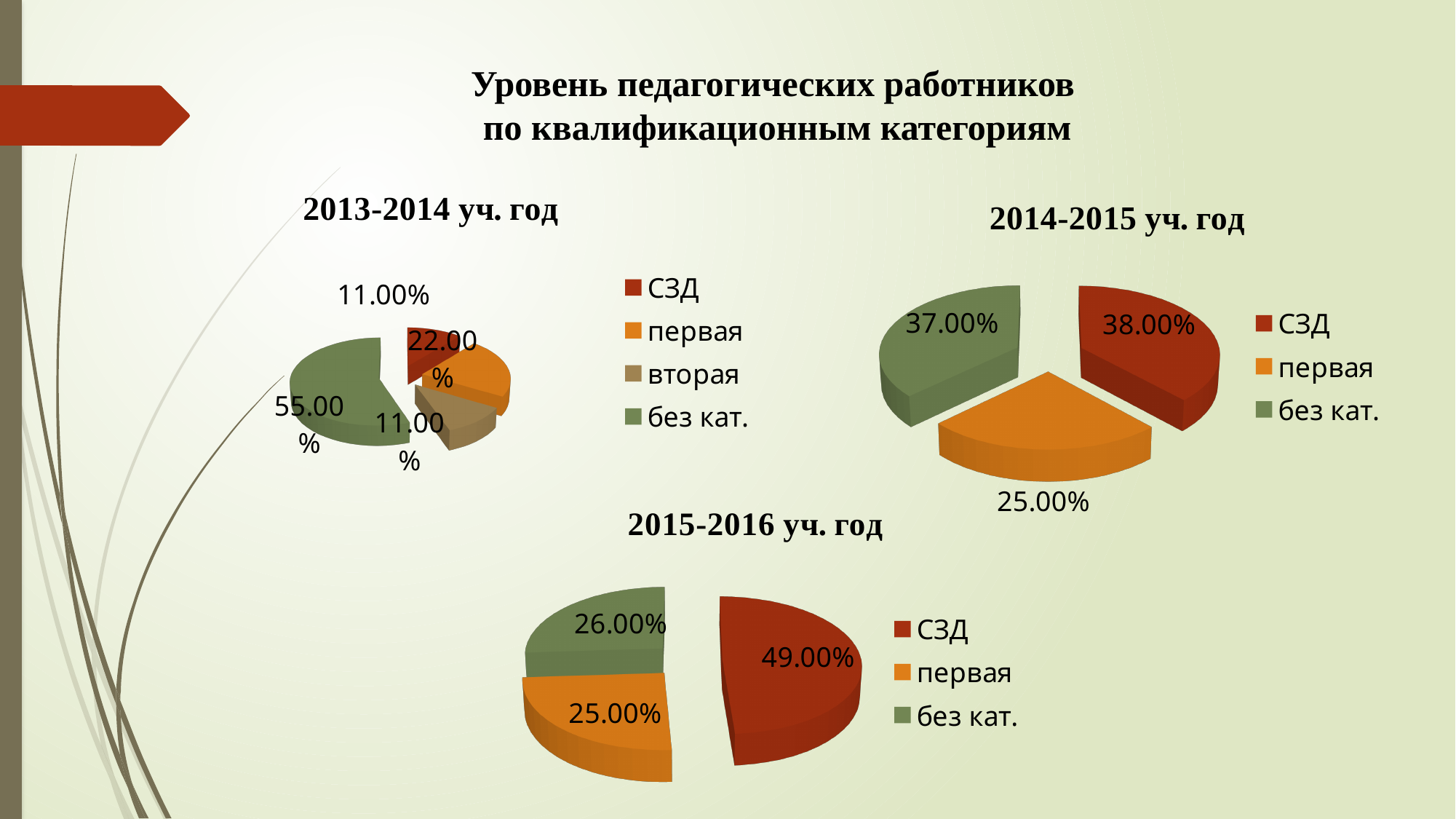
How many categories does the legend of the 2013-2014 уч. год chart list? 4 How many slices does the 2015-2016 уч. год chart have? 3 In the 2014-2015 уч. год chart, what is the value for СЗД? 38.00% What type of chart is the 2014-2015 уч. год chart? Pie chart In the 2014-2015 уч. год chart, which is larger, первая or без кат.? без кат. In the 2015-2016 уч. год chart, what is the value for без кат.? 26.00% In the 2013-2014 уч. год chart, what is the value for первая? 22.00% In the 2013-2014 уч. год chart, what share does без кат. have? 55.00% In the 2015-2016 уч. год chart, what is the difference between СЗД and первая? 24.00% In the 2013-2014 уч. год chart, which category has the largest share? без кат. In the 2015-2016 уч. год chart, which category has the largest share? СЗД In the 2014-2015 уч. год chart, which category has the smallest share? первая